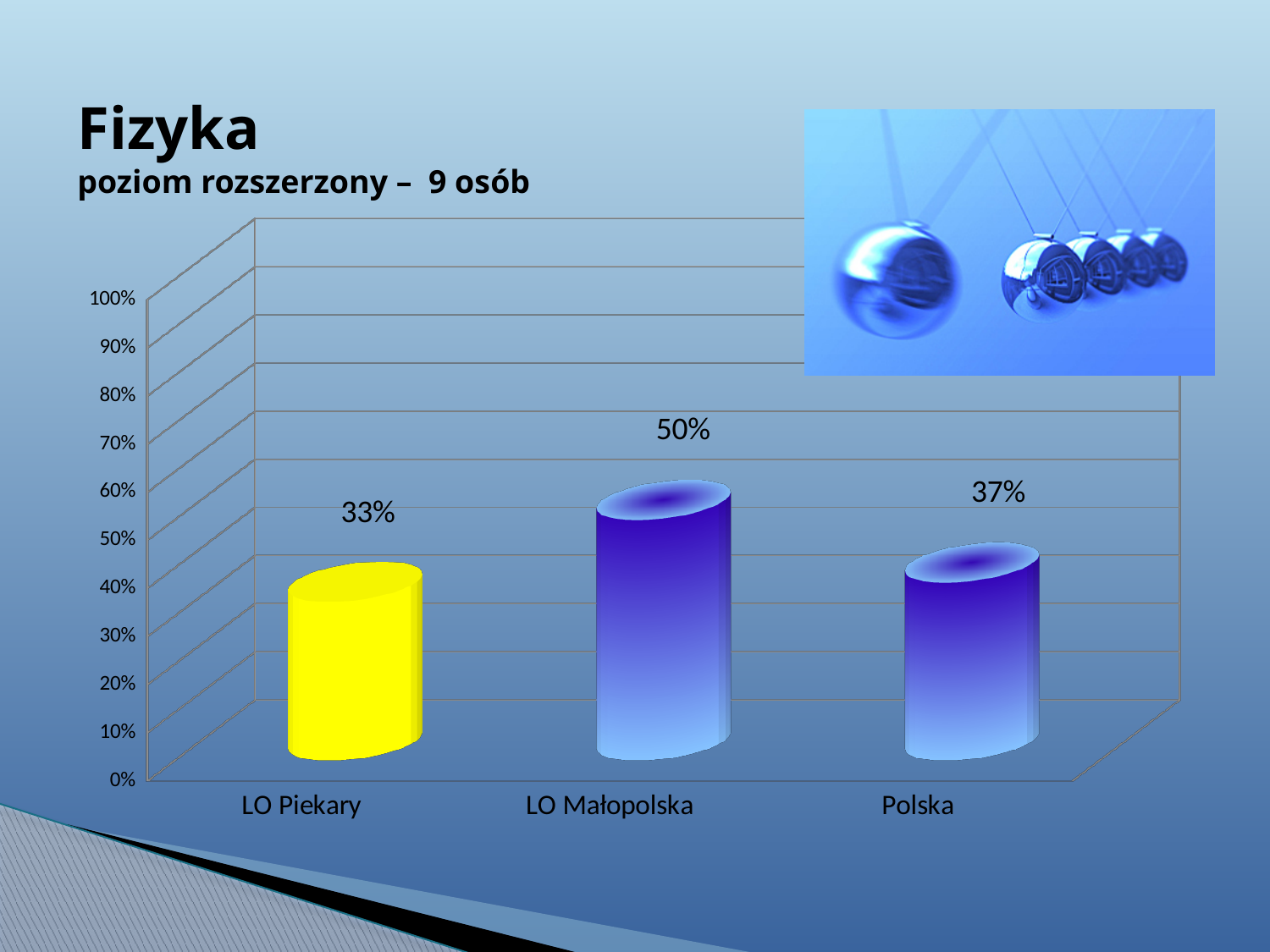
How many categories are shown on the x axis? 3 What kind of chart is shown on the slide? bar chart What is the value for LO Piekary? 33% Which bar is coloured yellow? LO Piekary Which category has the highest value? LO Małopolska What is the value for Polska? 37% Which category has the lowest value? LO Piekary What is the difference between the values for LO Małopolska and LO Piekary? 17% What is the value for LO Małopolska? 50% What is the difference between the values for Polska and LO Piekary? 4% Which is larger, the value for LO Małopolska or the value for Polska? LO Małopolska Is the value for LO Małopolska greater or less than 40%? greater